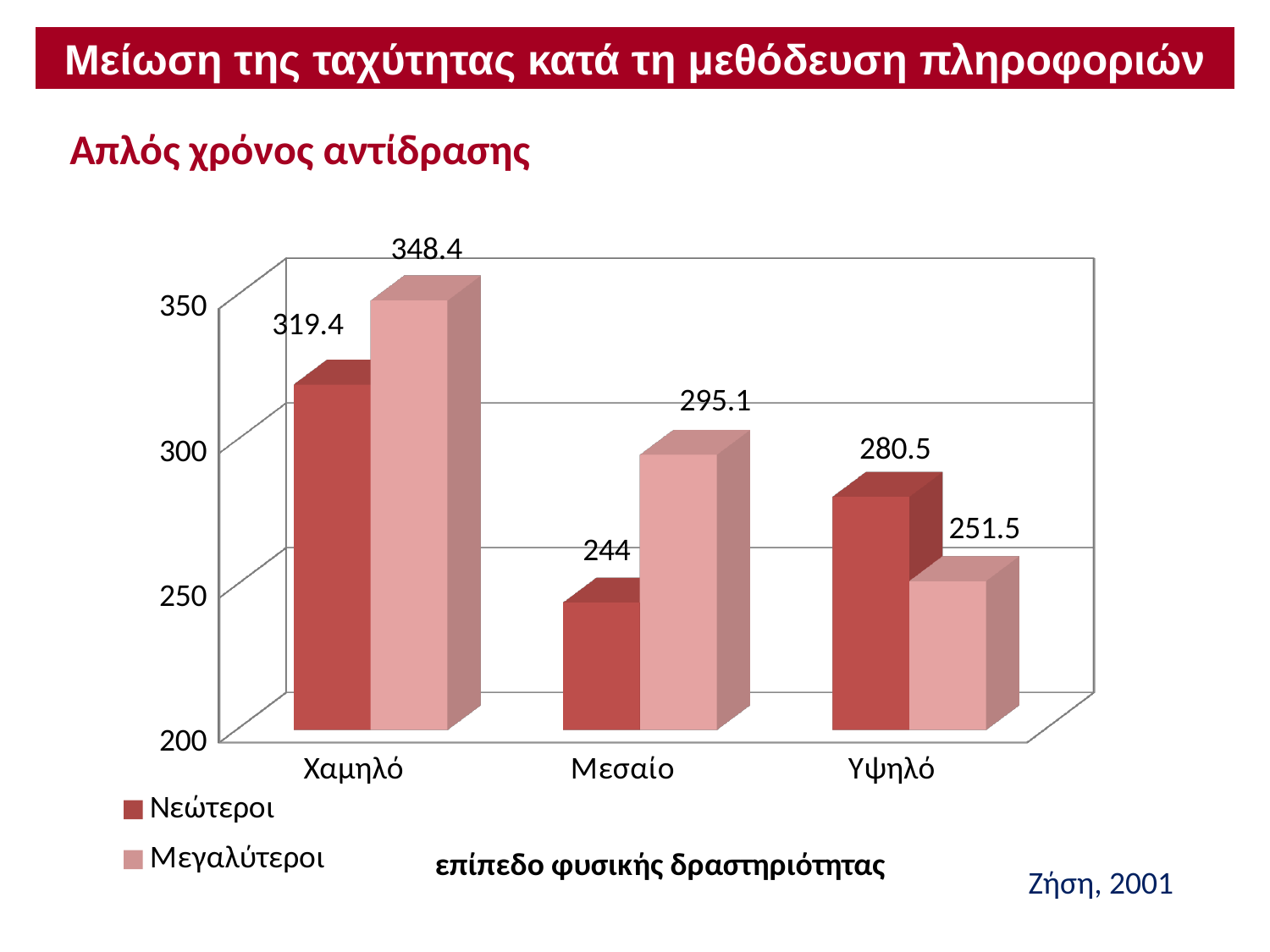
How many activity levels are shown on the x axis? 3 What is the value for Νεώτεροι at the Χαμηλό level? 319.4 How many series does the legend list? 2 What is the difference between Μεγαλύτεροι and Νεώτεροι at the Χαμηλό level? 29 At the Υψηλό level, which series has the larger value, Νεώτεροι or Μεγαλύτεροι? Νεώτεροι Which activity level has the highest value for Μεγαλύτεροι? Χαμηλό What is the value for Μεγαλύτεροι at the Μεσαίο level? 295.1 What kind of chart is shown on the slide? bar chart What is the value for Μεγαλύτεροι at the Υψηλό level? 251.5 Is the value for Νεώτεροι at the Υψηλό level greater or less than 300? less Which activity level has the lowest value for Νεώτεροι? Μεσαίο What is the value for Νεώτεροι at the Μεσαίο level? 244